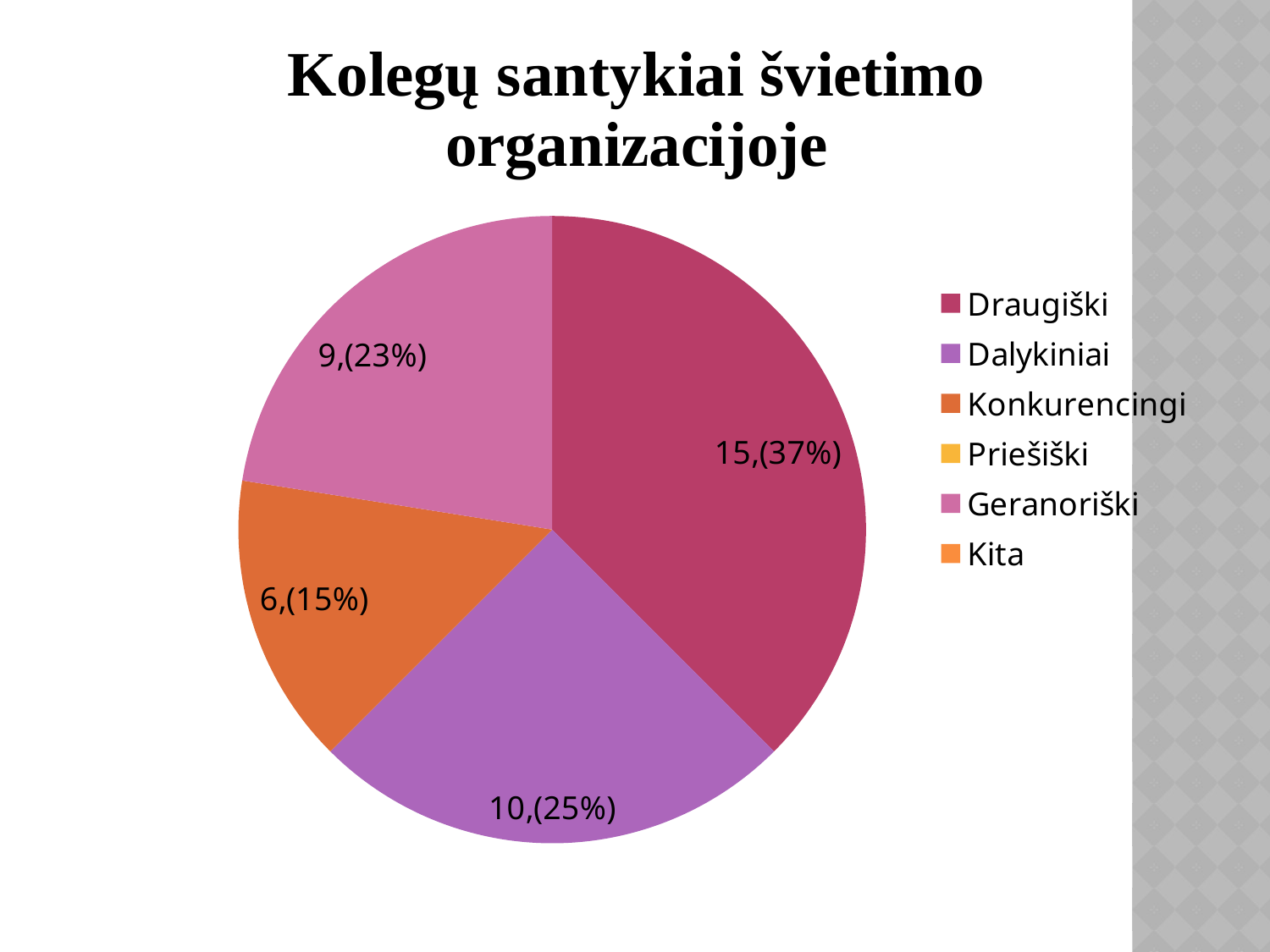
Which category has the largest slice of the pie? Draugiški What kind of chart is shown on the slide? pie chart Which is larger, the Dalykiniai slice or the Geranoriški slice? Dalykiniai What is the data label on the Geranoriški slice? 9,(23%) What is the title of the pie chart? Kolegų santykiai švietimo organizacijoje How many entries does the legend list? 6 What is the data label on the Draugiški slice? 15,(37%) What percentage share of the pie does the Dalykiniai slice represent? 25% What is the data label on the Dalykiniai slice? 10,(25%) What percentage share of the pie does the Draugiški slice represent? 37% How many slices with data labels are visible in the pie? 4 What is the difference between the count for Draugiški and the count for Dalykiniai? 5